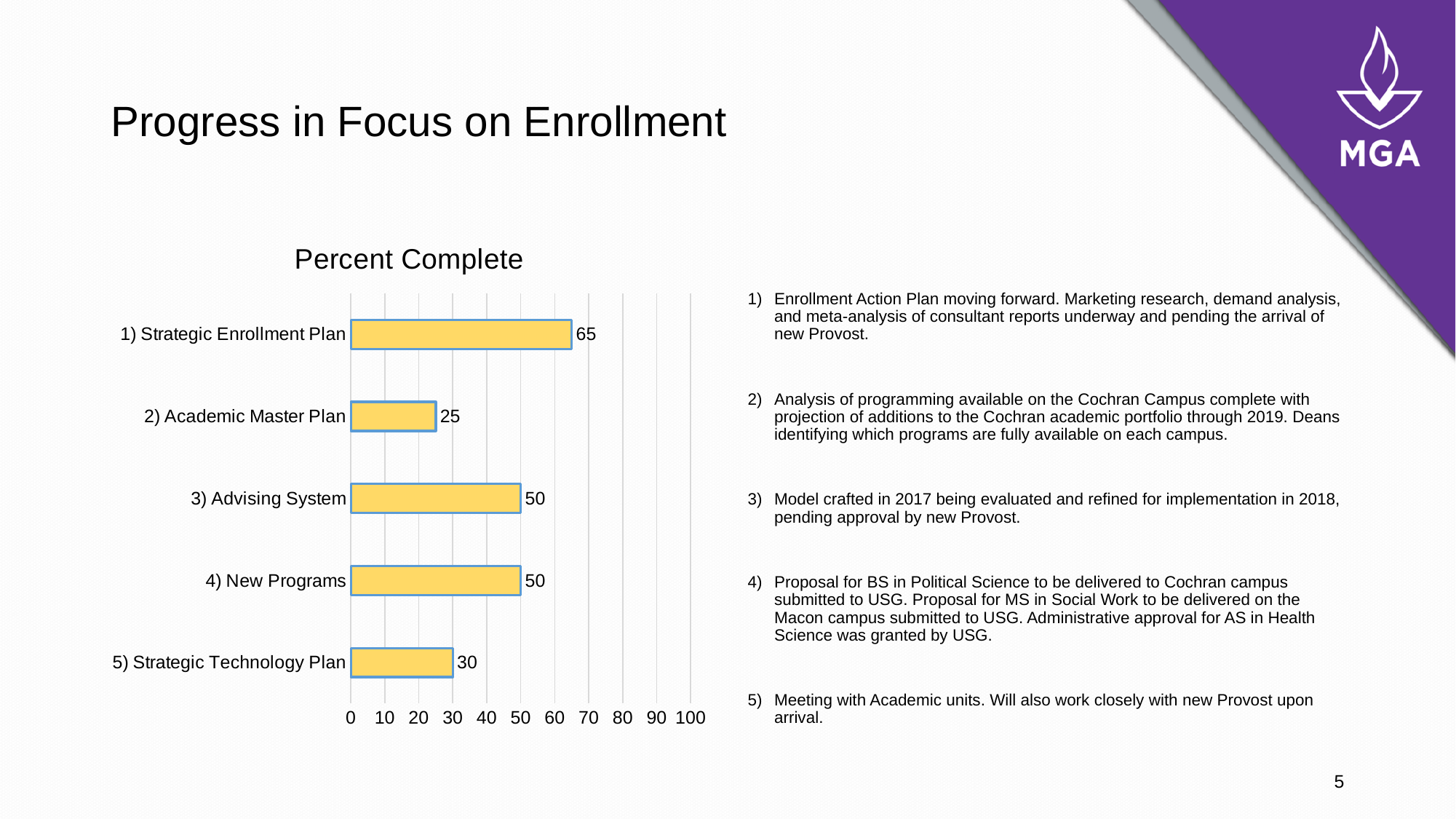
Which category has the lowest percent complete? 2) Academic Master Plan How many categories are shown in the chart? 5 Is the value for 1) Strategic Enrollment Plan greater or less than 60? greater What is the difference between the values for 3) Advising System and 5) Strategic Technology Plan? 20 Which category has the highest percent complete? 1) Strategic Enrollment Plan What is the title of the chart? Percent Complete Which is larger, the value for 5) Strategic Technology Plan or the value for 2) Academic Master Plan? 5) Strategic Technology Plan What is the difference between the values for 1) Strategic Enrollment Plan and 2) Academic Master Plan? 40 What is the percent complete value for 5) Strategic Technology Plan? 30 What kind of chart is shown on the slide? Bar chart What is the percent complete value for 1) Strategic Enrollment Plan? 65 What is the percent complete value for 2) Academic Master Plan? 25